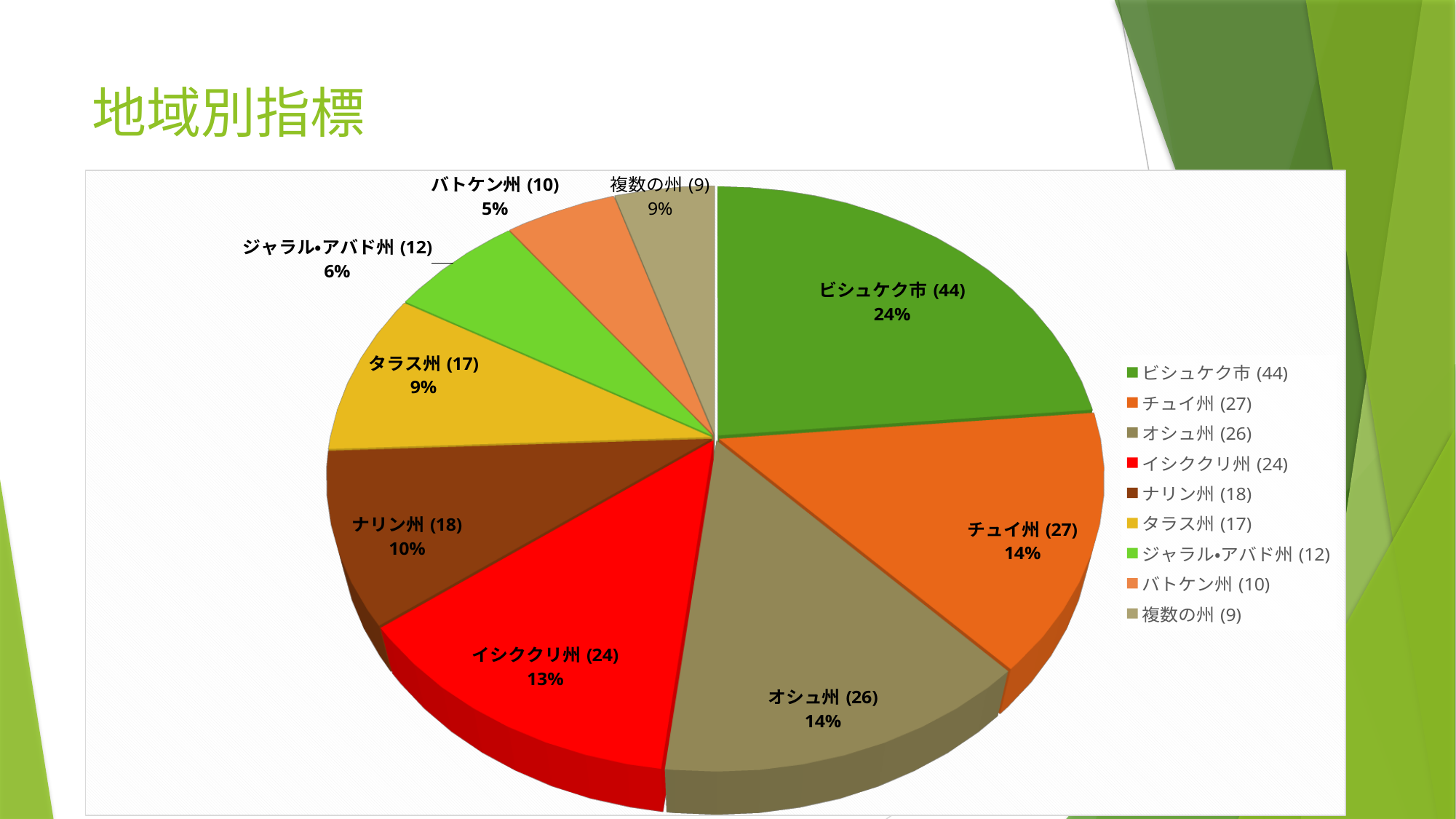
What percentage share is shown for ビシュケク市? 24% What percentage share is shown for ナリン州? 10% What count is shown in parentheses for タラス州? 17 What is the difference between the counts shown for ビシュケク市 (44) and チュイ州 (27)? 17 Which category has the largest slice in the pie chart? ビシュケク市 (44) What is the title of the slide? 地域別指標 What percentage share is shown for ジャラル・アバド州? 6% Which category has the smallest slice in the pie chart? 複数の州 (9) How many slices does the pie chart have? 9 What kind of chart is shown on the slide? pie chart Which has the larger count shown in its label, チュイ州 or オシュ州? チュイ州